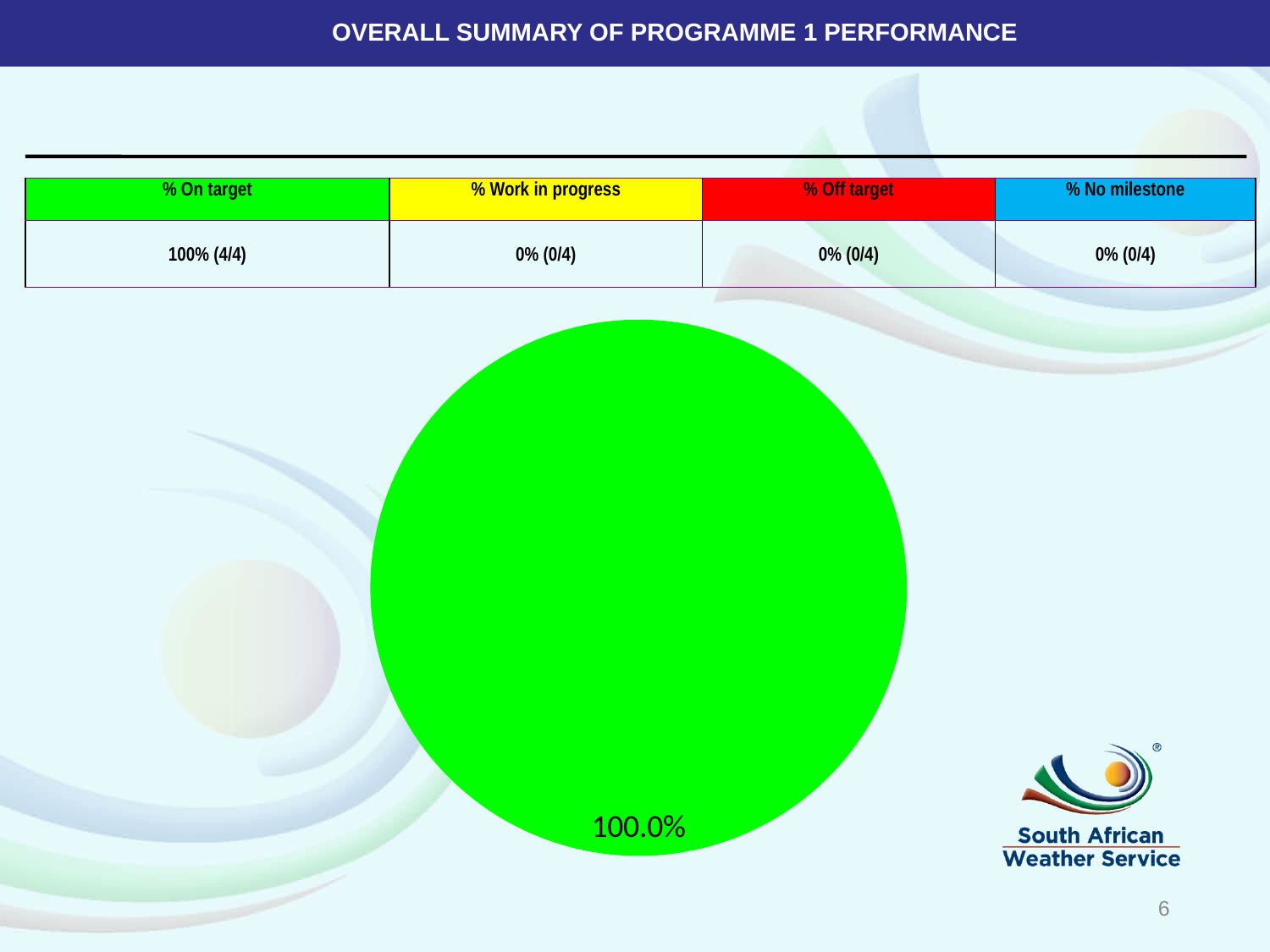
What value does the table above the chart give for % Off target? 0% (0/4) What kind of chart is shown on the slide? pie chart What colour is the slice that fills the pie chart? green What share of the pie does the single green slice represent, according to its data label? 100.0% How many slices are visible in the pie chart? 1 What value does the table above the chart give for % On target? 100% (4/4) Based on the colour key in the table above the chart, which category does the green pie slice correspond to? % On target Is the share shown by the pie chart's data label greater or less than 50%? greater